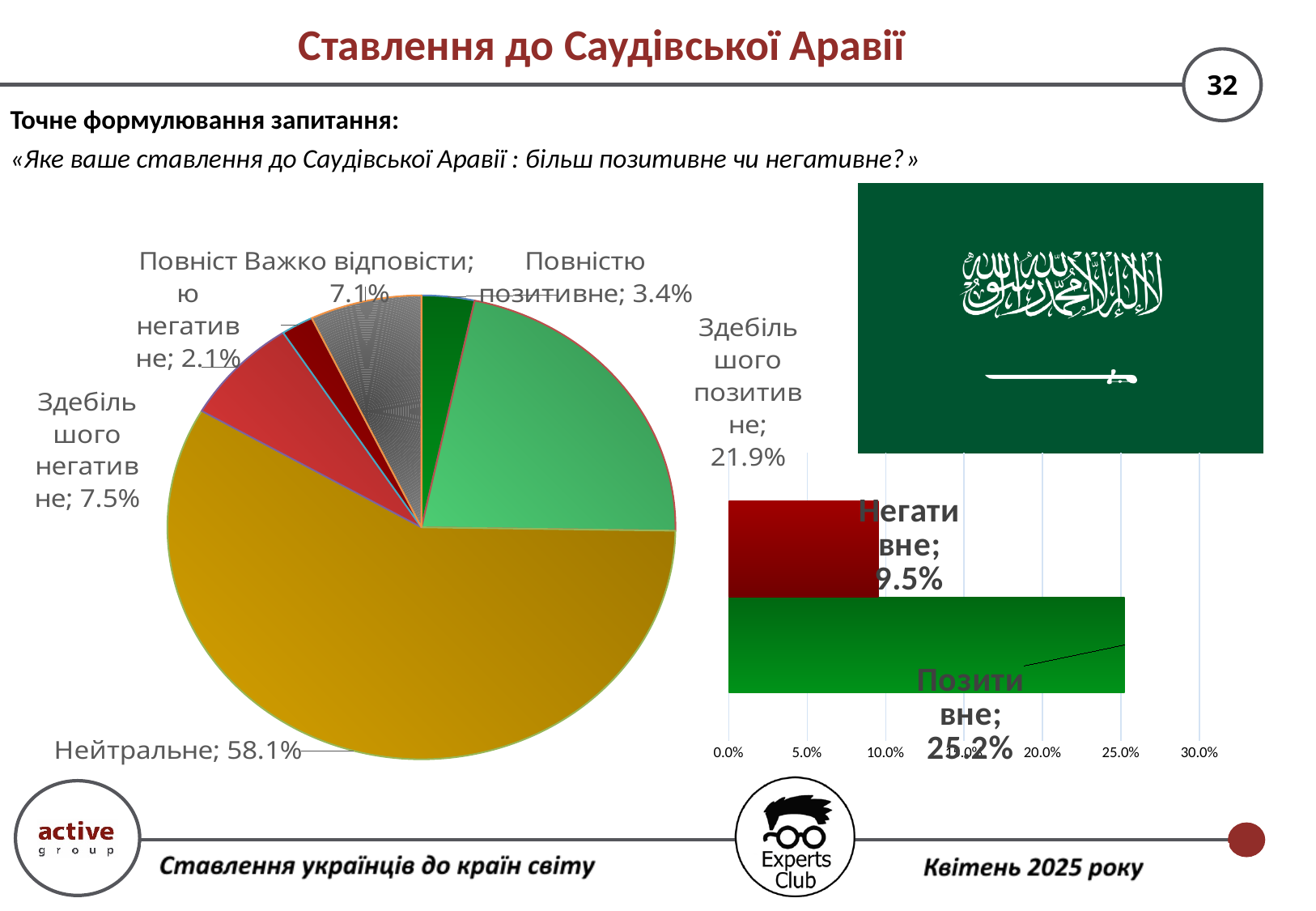
On the bar chart on the right, what is the difference between "Позитивне" and "Негативне"? 15.7% On the pie chart, how many slices are there? 6 On the bar chart on the right, what is the value for "Негативне"? 9.5% What type of chart is shown on the right side of the slide? Bar chart On the pie chart, which category has the smallest share? Повністю негативне On the pie chart, what share of respondents answered "Нейтральне"? 58.1% On the pie chart, what is the difference between "Здебільшого позитивне" and "Здебільшого негативне"? 14.4% On the pie chart, which is larger: "Повністю позитивне" or "Повністю негативне"? Повністю позитивне On the bar chart on the right, what is the value for "Позитивне"? 25.2% On the pie chart, what is the value for "Важко відповісти"? 7.1% On the pie chart, what is the value for "Здебільшого позитивне"? 21.9% On the pie chart, which category has the largest share? Нейтральне